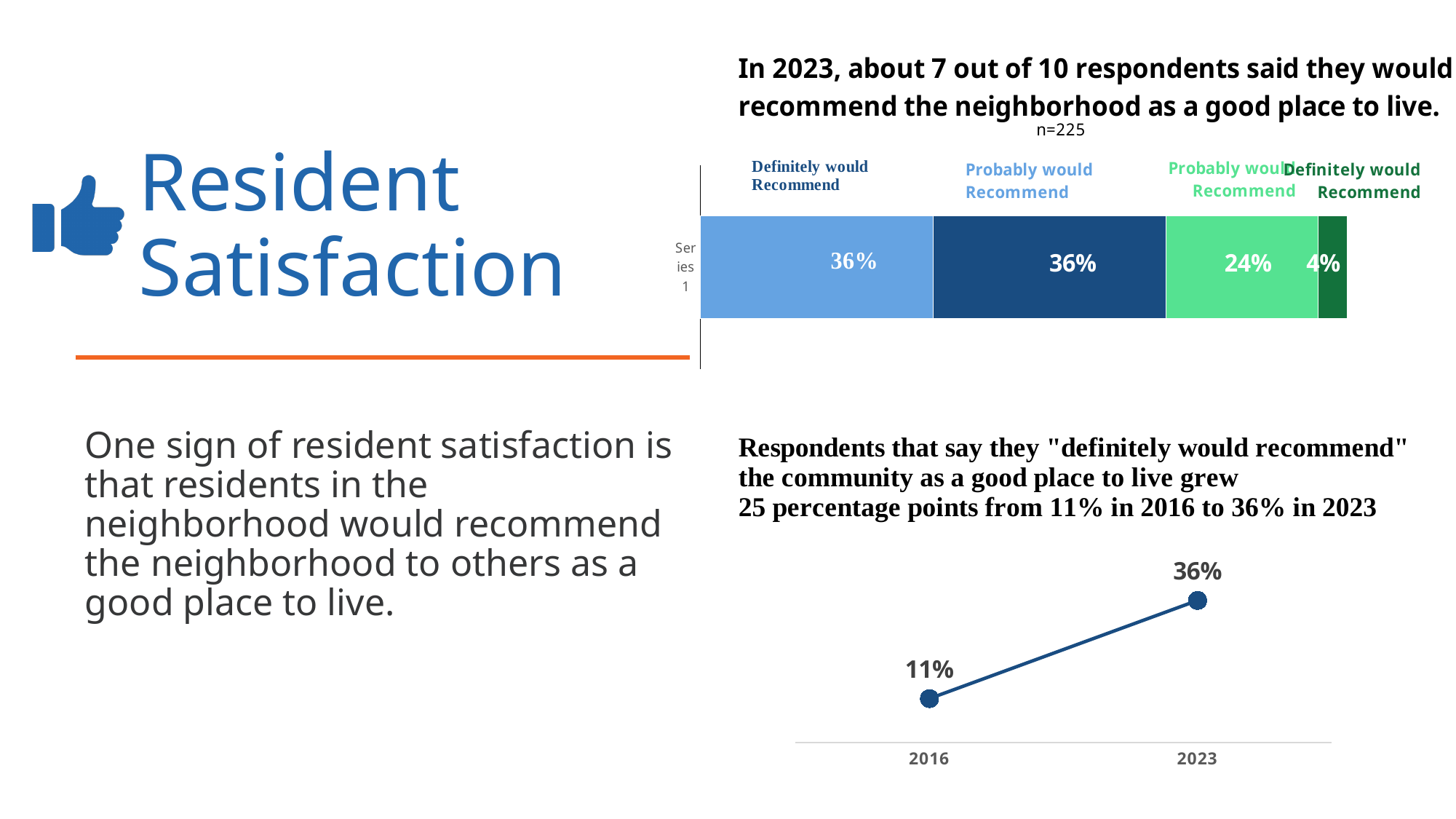
In the top-right stacked bar chart, what is the value of the light green segment? 24% In the bottom-right line chart, what is the value for 2023? 36% In the top-right stacked bar chart, which segment has the smallest value? The dark green segment (4%) In the top-right chart, what sample size (n) is shown? n=225 In the top-right stacked bar chart, what is the value of the light blue segment? 36% In the top-right stacked bar chart, how many segments make up the bar? 4 In the top-right stacked bar chart, what is the difference between the light green segment and the dark green segment? 20 percentage points In the bottom-right line chart, what is the difference between the 2023 value and the 2016 value? 25 percentage points In the top-right stacked bar chart, what is the value of the dark green segment? 4% In the top-right stacked bar chart, what is the total of all the segments in the bar? 100% In the bottom-right line chart, what is the value for 2016? 11% In the bottom-right chart, do the values rise or fall from 2016 to 2023? Rise